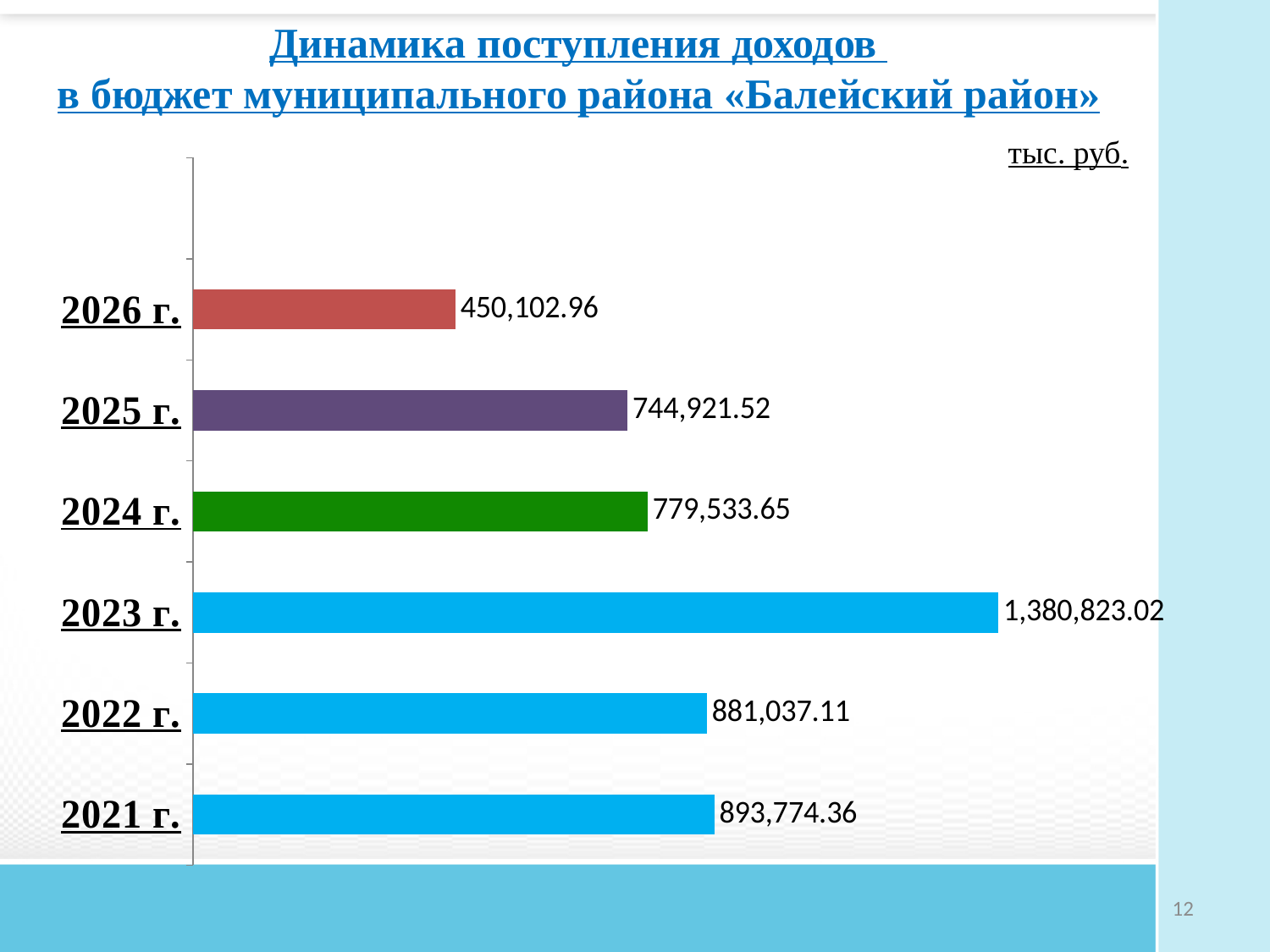
How many years are shown in the chart? 6 What is the value for 2023 г.? 1,380,823.02 What is the value for 2021 г.? 893,774.36 What is the value for 2024 г.? 779,533.65 What is the difference between the values for 2023 г. and 2022 г.? 499,785.91 Which year has the highest value? 2023 г. What is the value for 2026 г.? 450,102.96 What is the difference between the values for 2025 г. and 2026 г.? 294,818.56 Which is larger, the value for 2021 г. or the value for 2022 г.? 2021 г. Which year has the lowest value? 2026 г. What unit is indicated for the chart values? тыс. руб. What kind of chart is shown on the slide? Bar chart